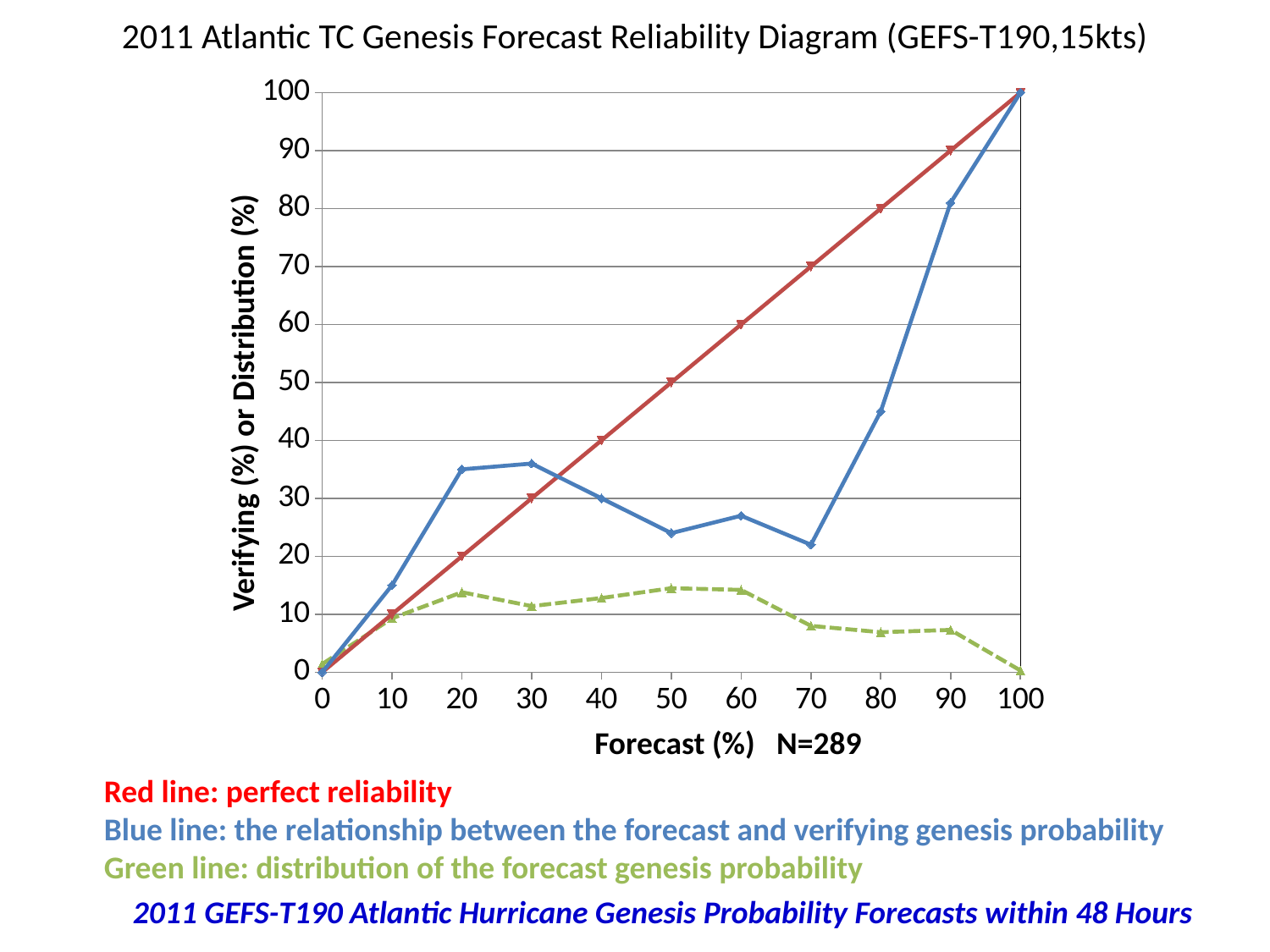
What sample size N is given in the x-axis label of the chart? N=289 How many forecast (%) points are marked along the x axis of the chart? 11 Does the red line rise or fall as the forecast (%) increases along the x axis? rises What type of chart is shown on the slide? line chart What is the value of the blue line at a forecast of 100%? 100 Is the value of the blue line at a forecast of 80% greater or less than 40? greater What is the title of the chart? 2011 Atlantic TC Genesis Forecast Reliability Diagram (GEFS-T190,15kts) How many lines are plotted on the chart? 3 What is the value of the red perfect reliability line at a forecast of 50%? 50 At a forecast of 20%, which line has the larger value, the blue line or the red line? blue line Is the value of the green line at a forecast of 90% greater or less than 10? less